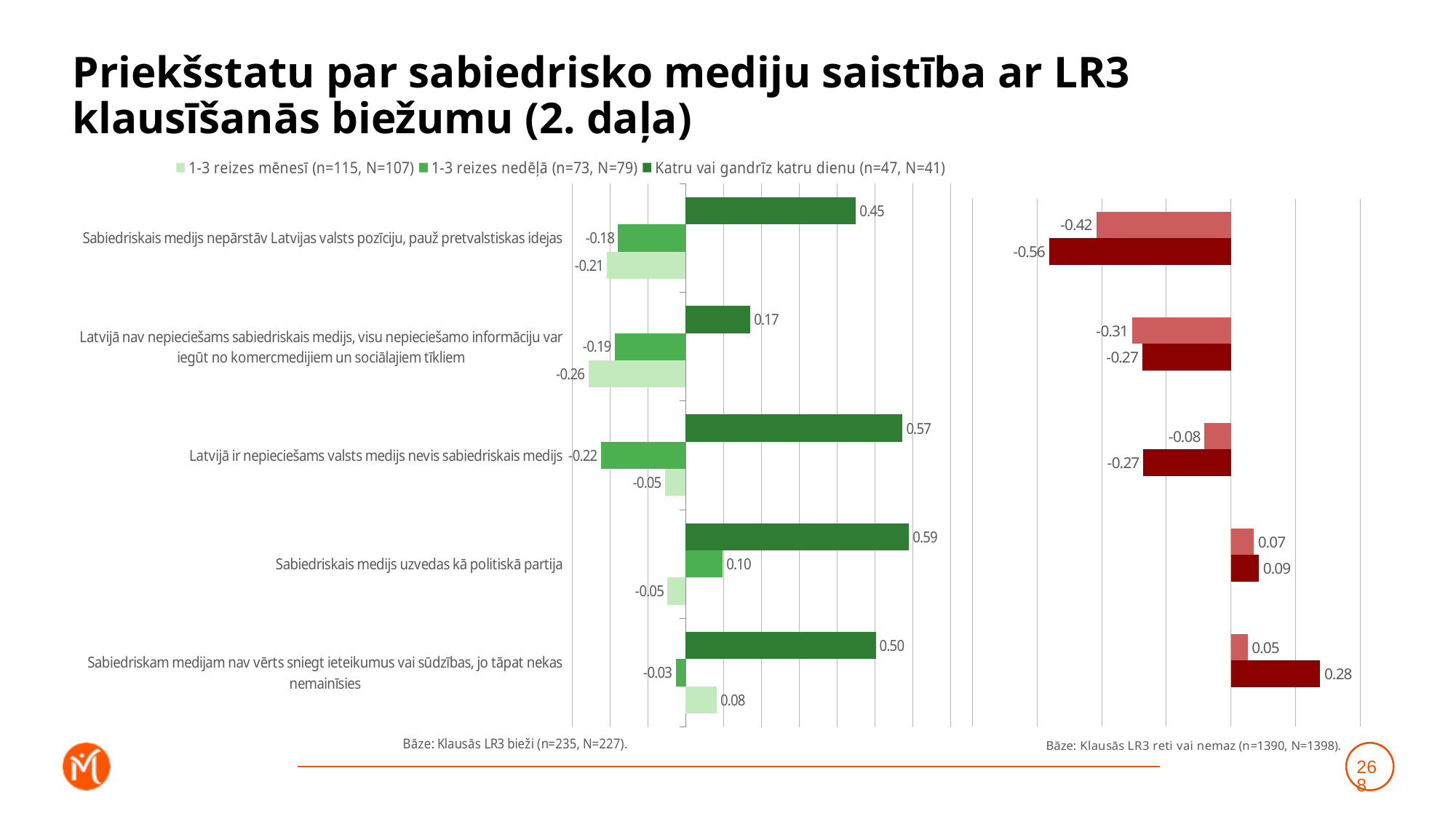
In the left (green) chart, what is the value for 'Katru vai gandrīz katru dienu' for the statement 'Sabiedriskais medijs uzvedas kā politiskā partija'? 0.59 What base (Bāze) is stated below the right (red) chart? Klausās LR3 reti vai nemaz (n=1390, N=1398) In the left (green) chart, for the statement 'Sabiedriskam medijam nav vērts sniegt ieteikumus vai sūdzības, jo tāpat nekas nemainīsies', which is larger: the '1-3 reizes mēnesī' value or the '1-3 reizes nedēļā' value? 1-3 reizes mēnesī What type of chart is the left (green) chart? Bar chart In the left (green) chart, what is the value for '1-3 reizes nedēļā' for the statement 'Sabiedriskais medijs uzvedas kā politiskā partija'? 0.10 In the legend of the left (green) chart, what sample sizes are given for '1-3 reizes nedēļā'? n=73, N=79 In the left (green) chart, which statement has the lowest value for '1-3 reizes nedēļā'? Latvijā ir nepieciešams valsts medijs nevis sabiedriskais medijs How many statements (categories) are shown in the left (green) chart? 5 In the left (green) chart, which statement has the highest value for 'Katru vai gandrīz katru dienu'? Sabiedriskais medijs uzvedas kā politiskā partija How many series does the legend of the left (green) chart list? 3 In the left (green) chart, what is the difference between the 'Katru vai gandrīz katru dienu' value and the '1-3 reizes nedēļā' value for the statement 'Sabiedriskais medijs nepārstāv Latvijas valsts pozīciju, pauž pretvalstiskas idejas'? 0.63 In the left (green) chart, what is the value for '1-3 reizes mēnesī' for the statement 'Latvijā nav nepieciešams sabiedriskais medijs, visu nepieciešamo informāciju var iegūt no komercmedijiem un sociālajiem tīkliem'? -0.26